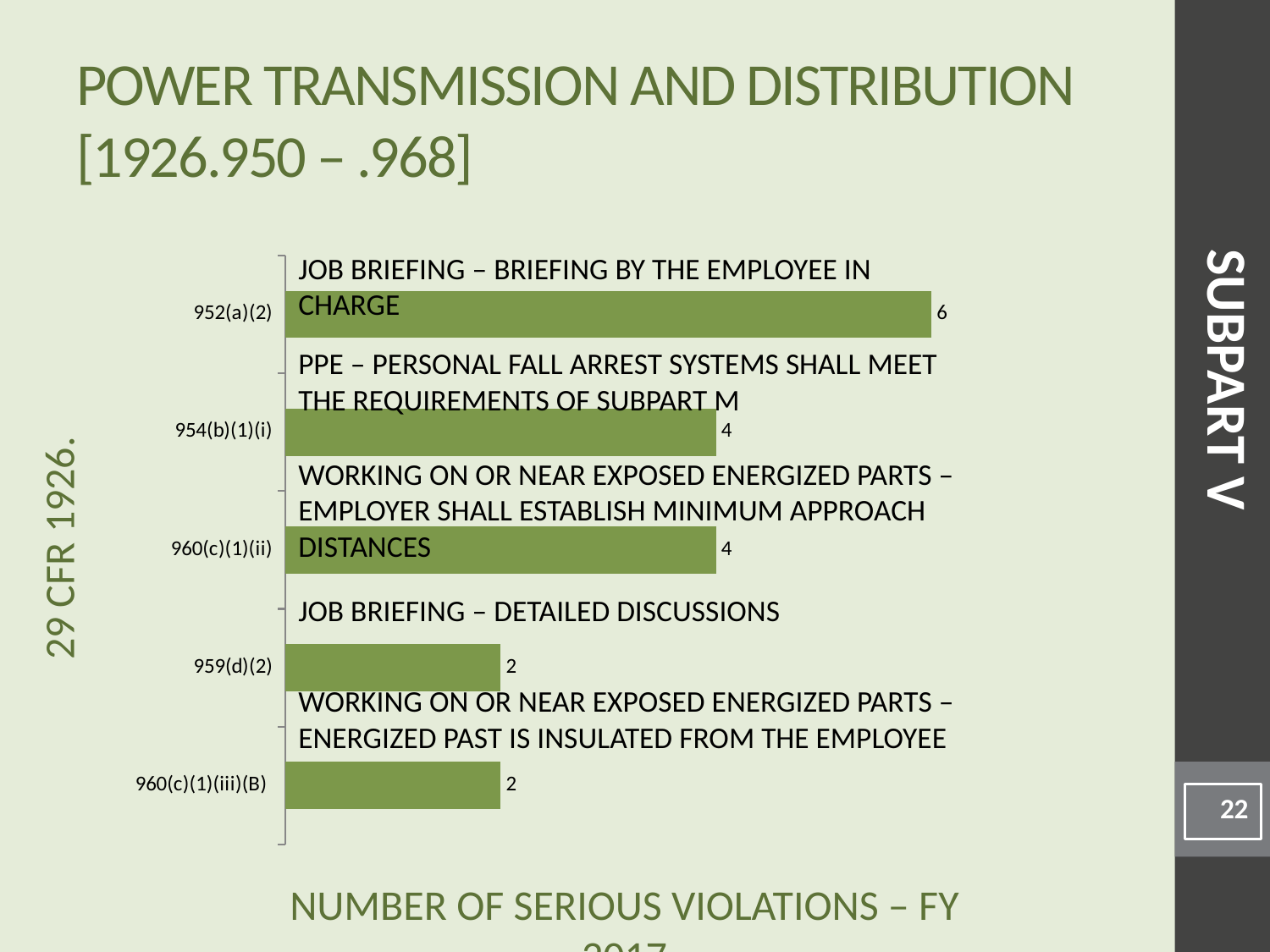
What is the number of serious violations for 960(c)(1)(iii)(B)? 2 What is the number of serious violations for 952(a)(2)? 6 What is the difference between the values for 952(a)(2) and 954(b)(1)(i)? 2 What kind of chart is shown on the slide? Bar chart Which category has the highest number of serious violations? 952(a)(2) What is the difference between the values for 960(c)(1)(ii) and 959(d)(2)? 2 Which is larger, the value for 952(a)(2) or the value for 960(c)(1)(ii)? 952(a)(2) How many categories are shown in the chart? 5 What is the number of serious violations for 959(d)(2)? 2 What is the label on the vertical axis of the chart? 29 CFR 1926. What is the total number of serious violations across all five categories? 18 What is the number of serious violations for 954(b)(1)(i)? 4